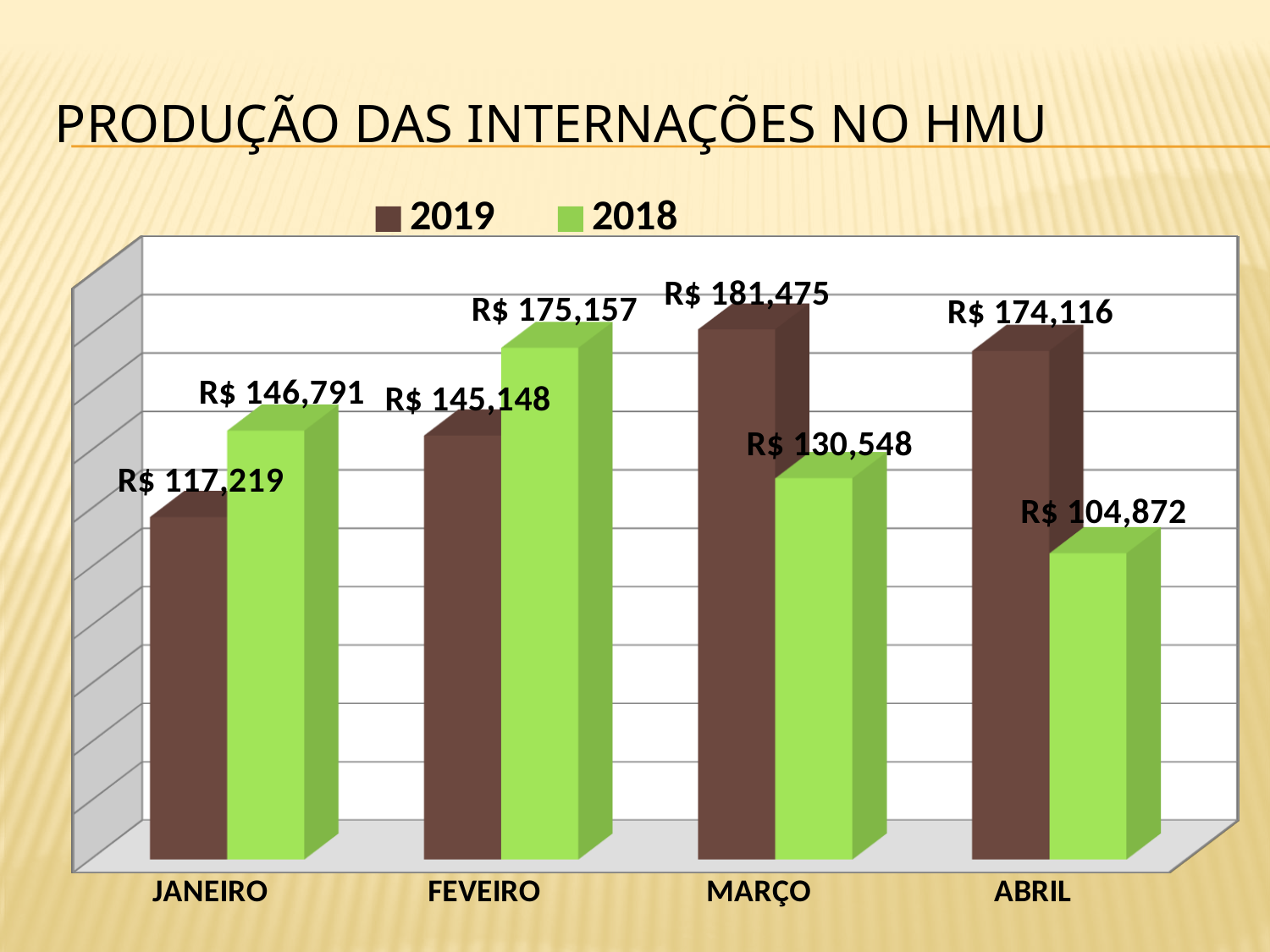
What is the value for 2018 in FEVEIRO? R$ 175,157 What is the value for 2018 in ABRIL? R$ 104,872 Which is larger in JANEIRO, the 2019 value or the 2018 value? 2018 How many series does the legend list? 2 What is the value for 2019 in MARÇO? R$ 181,475 What is the title of the slide? PRODUÇÃO DAS INTERNAÇÕES NO HMU In which month is the 2018 value lowest? ABRIL What is the value for 2019 in JANEIRO? R$ 117,219 How many months are shown on the x axis? 4 What is the difference between the 2019 and 2018 values in MARÇO? R$ 50,927 What kind of chart is shown on the slide? Bar chart In which month is the 2019 value highest? MARÇO